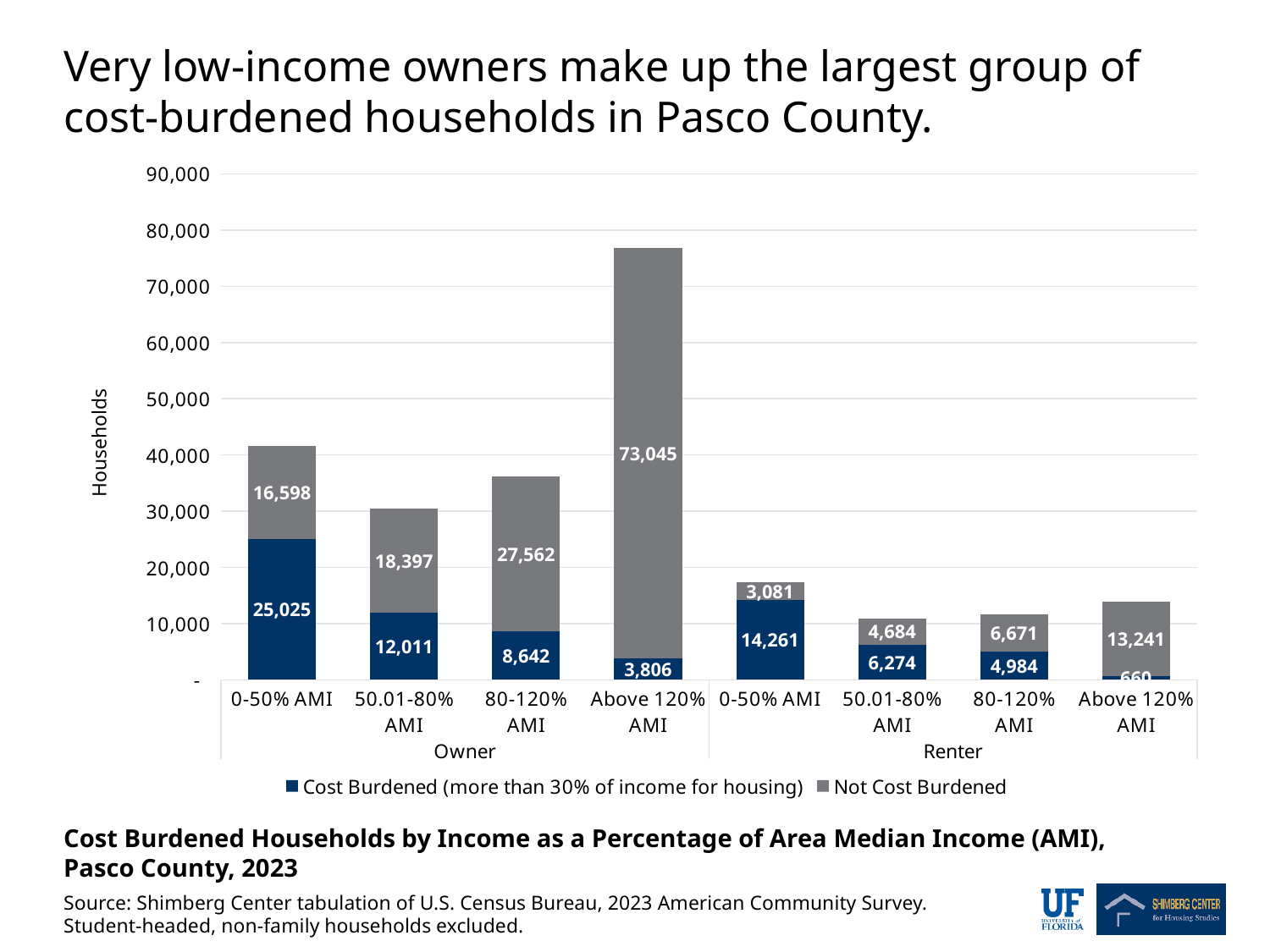
How many cost-burdened renter households are in the 0-50% AMI group? 14,261 What is the difference between cost-burdened owner households in the 0-50% AMI group and the 50.01-80% AMI group? 13,014 How many not-cost-burdened renter households are in the 80-120% AMI group? 6,671 What kind of chart is shown on the slide? Stacked bar chart Which income group has the highest number of cost-burdened households? Owner 0-50% AMI How many series does the legend list? 2 How many not-cost-burdened owner households are in the Above 120% AMI group? 73,045 Which group has the tallest stacked bar overall? Owner Above 120% AMI Which is larger: cost-burdened renter households at 0-50% AMI or cost-burdened owner households at 50.01-80% AMI? Cost-burdened renter households at 0-50% AMI How many cost-burdened owner households are in the 0-50% AMI group? 25,025 What is the total number of owner households in the 0-50% AMI group (cost burdened plus not cost burdened)? 41,623 Is the total height of the Owner Above 120% AMI bar greater or less than 70,000? greater